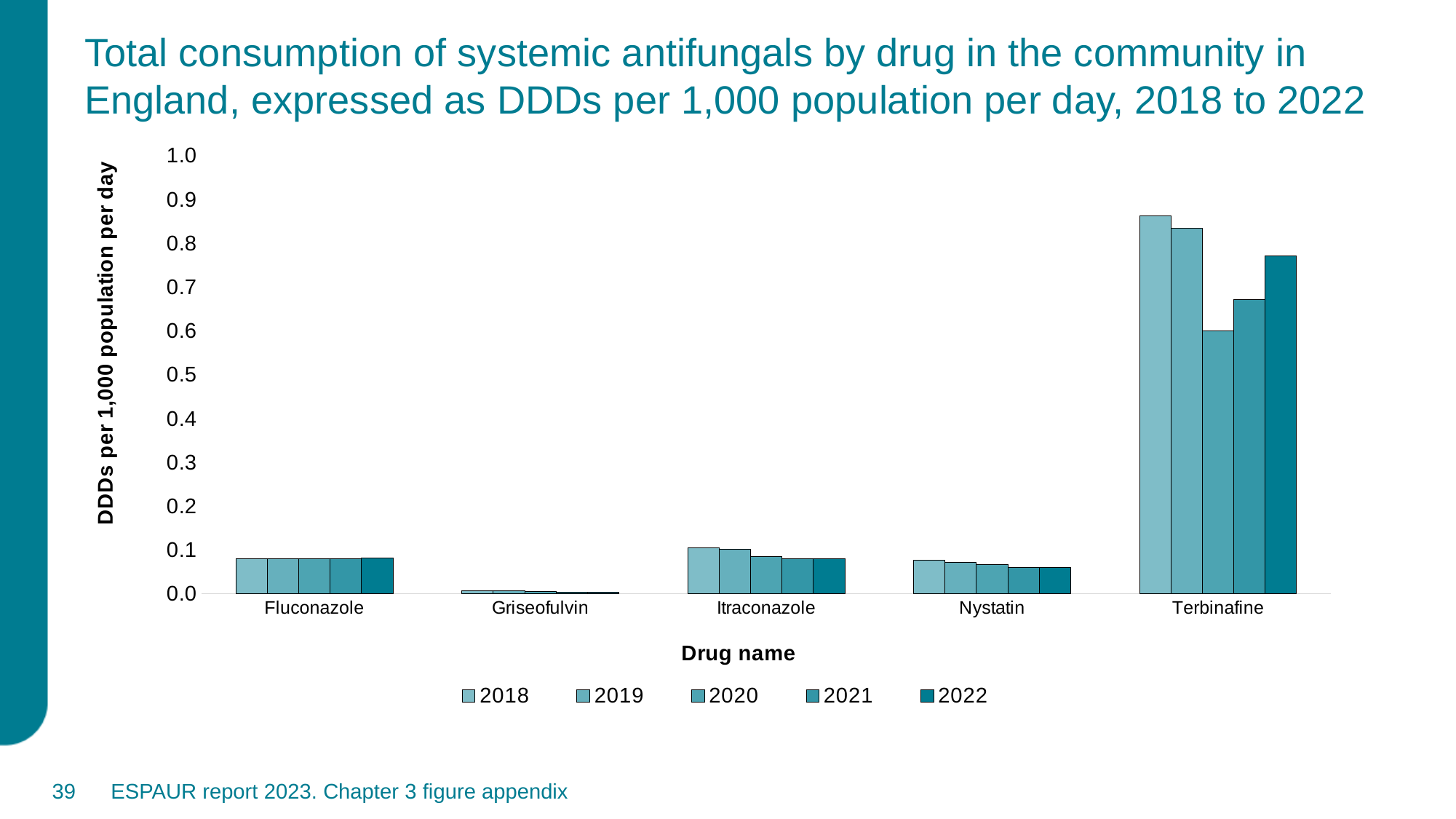
Is the value for Terbinafine in 2018 greater or less than 0.8? greater How many series does the legend list? 5 Which drug has the highest consumption in the chart? Terbinafine Is the value for Fluconazole in 2022 greater or less than 0.1? less Is the value for Terbinafine in 2020 greater or less than 0.7? less Do the values for Itraconazole rise or fall from 2018 to 2022? fall For Terbinafine, which year has the larger value, 2018 or 2022? 2018 Which drug has the lowest consumption in the chart? Griseofulvin For Terbinafine, which year has the larger value, 2020 or 2021? 2021 How many drug names are shown on the x axis? 5 What kind of chart is shown on the slide? Bar chart What is the title of the y axis? DDDs per 1,000 population per day